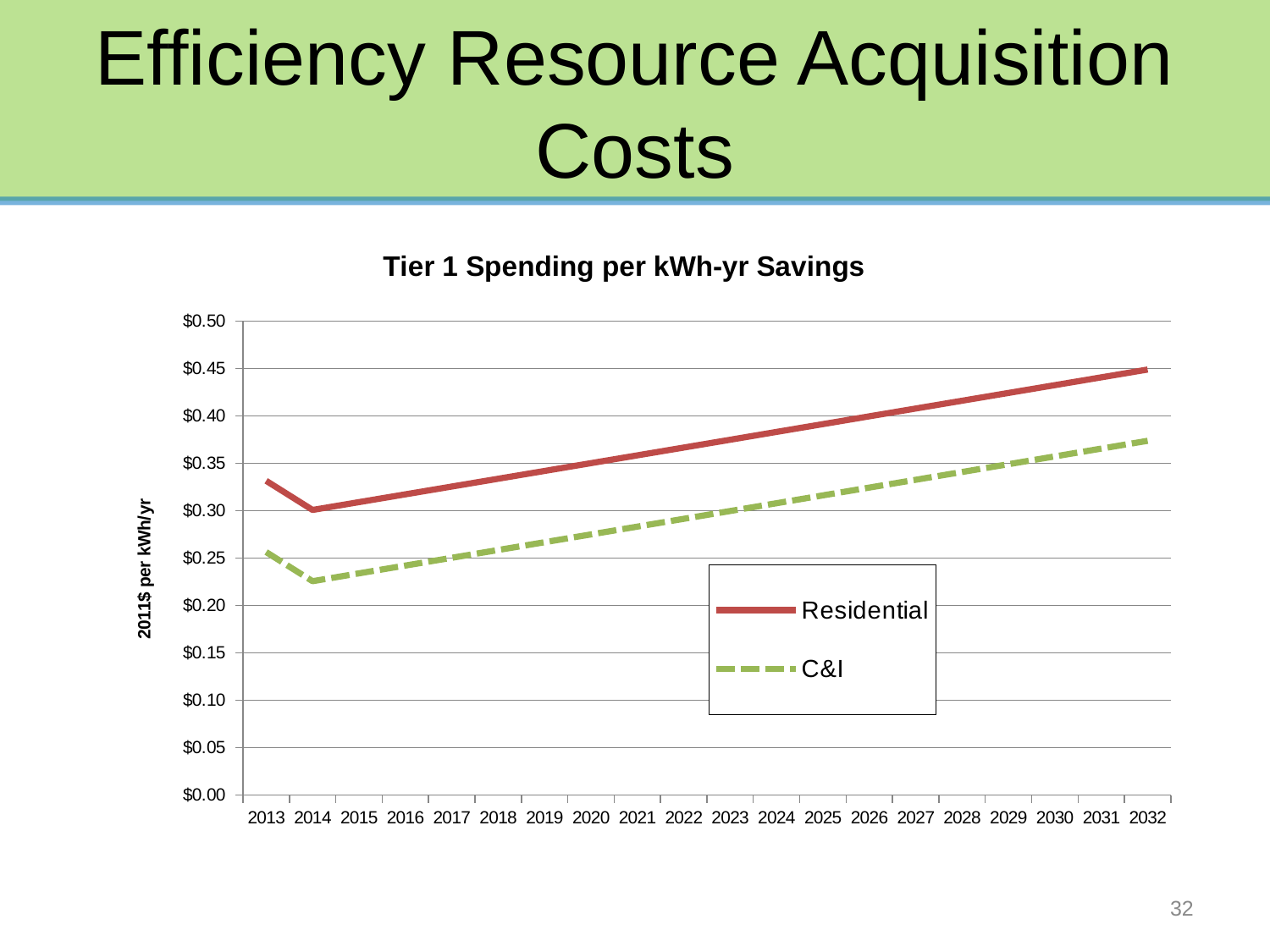
In which year is the Residential series at its highest? 2032 What is the label on the vertical axis? 2011$ per kWh/yr In which year is the Residential series at its lowest? 2014 How many series does the legend list? 2 What is the title of the chart? Tier 1 Spending per kWh-yr Savings Is the C&I value for 2014 greater or less than $0.25? less Is the C&I value for 2032 greater or less than $0.35? greater What kind of chart is shown on the slide? line chart Is the C&I value for 2013 greater or less than $0.30? less Which series has the larger value in 2032, Residential or C&I? Residential How many years are shown on the x axis? 20